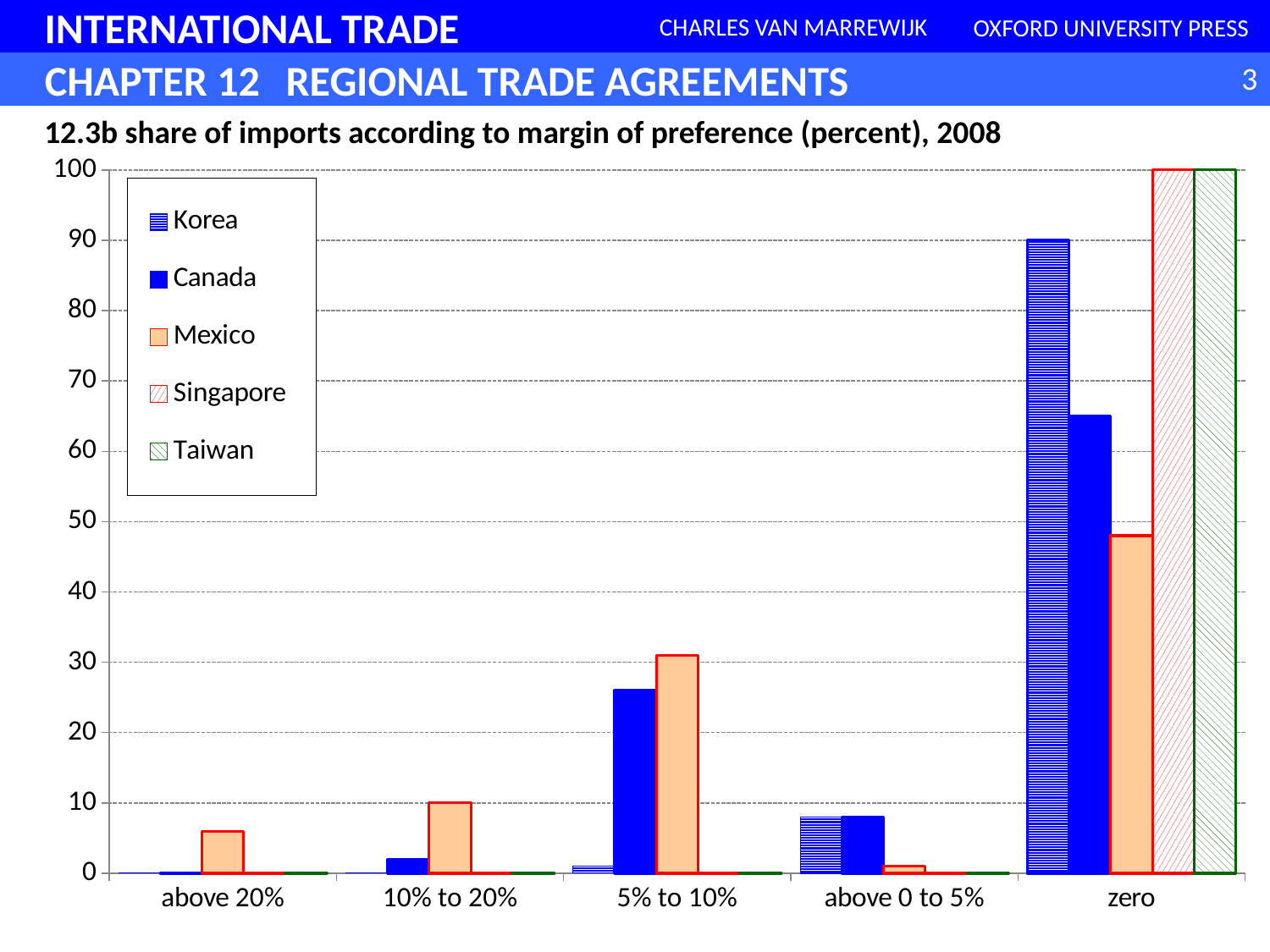
Is the value for Canada in the 'zero' category greater or less than 60? greater Is the value for Mexico in the 'zero' category greater or less than 50? less How many series does the legend list? 5 Do the values for Korea rise or fall moving from 'above 20%' to 'zero' along the x axis? rise Which series has the highest value in the '5% to 10%' category? Mexico In the 'zero' category, which is larger: the value for Canada or the value for Mexico? Canada What type of chart is shown on the slide? bar chart What is the value for Mexico in the '10% to 20%' category? 10 How many margin-of-preference categories are shown on the x axis? 5 What is the value for Taiwan in the 'zero' category? 100 What is the value for Singapore in the 'zero' category? 100